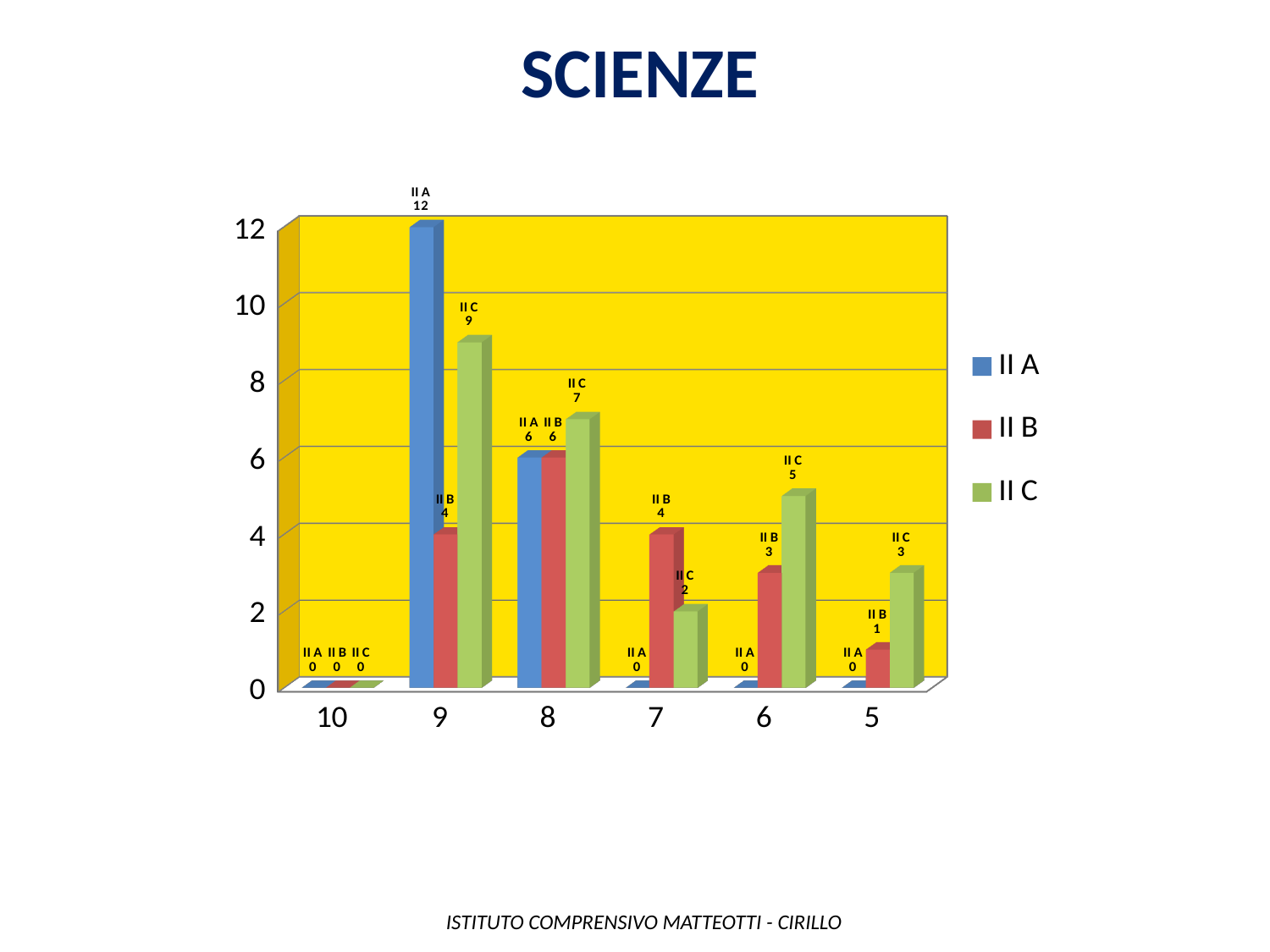
How many series does the legend list? 3 How many grade categories are shown on the x axis? 6 What is the value for II A at grade 9? 12 Which grade category has the highest value for II B? 8 What is the total of II A, II B and II C at grade 8? 19 What is the value for II B at grade 5? 1 Which is larger at grade 7: II B or II C? II B What is the value for II C at grade 6? 5 What is the title of the chart? SCIENZE What kind of chart is shown? bar chart Which grade category has the highest value for II C? 9 What is the difference between II A and II B at grade 9? 8